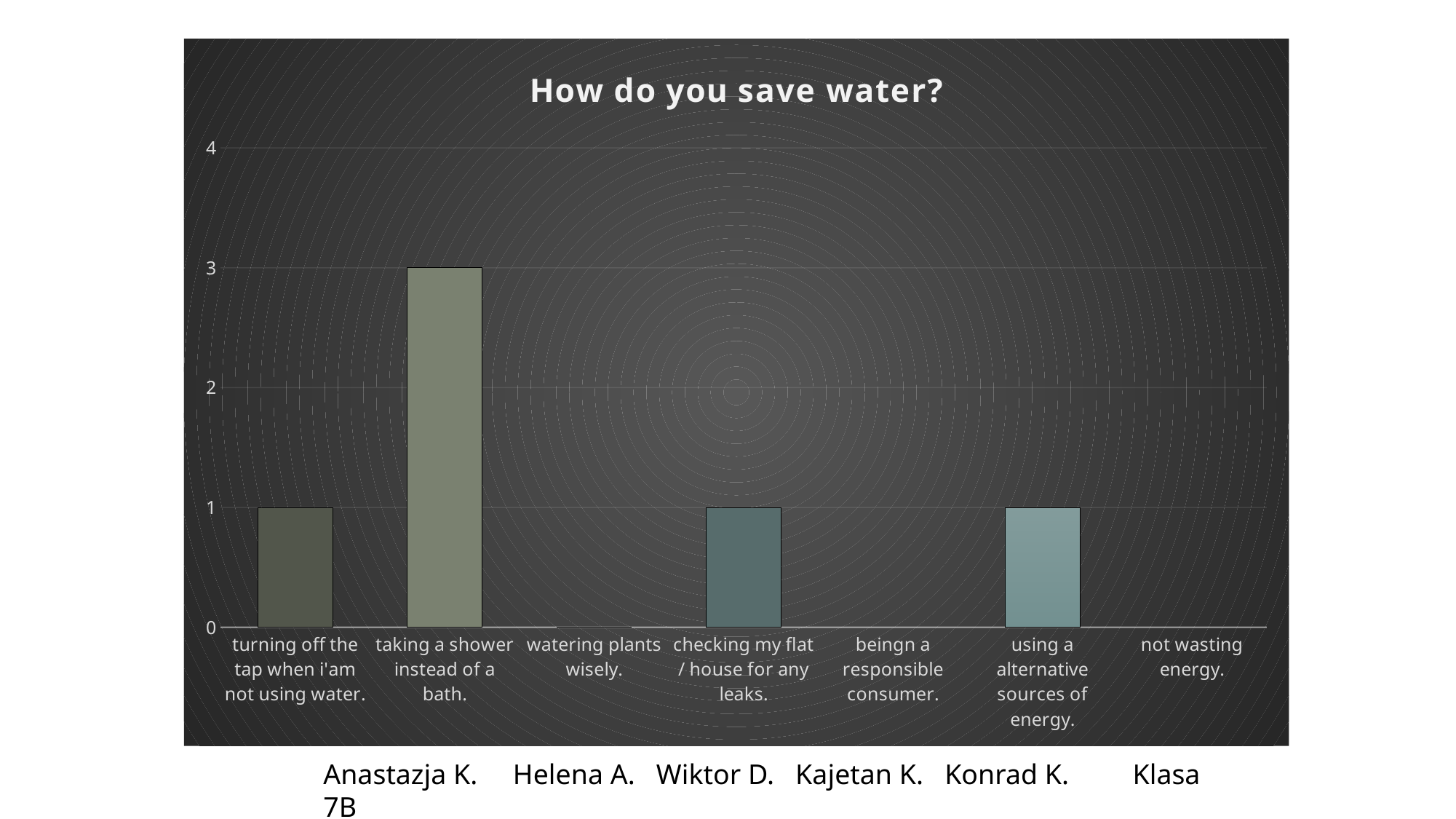
What is the difference between the values for "taking a shower instead of a bath." and "turning off the tap when i'am not using water."? 2 Is the value for "taking a shower instead of a bath." greater or less than 2? greater What is the title of the chart? How do you save water? What is the value for "turning off the tap when i'am not using water."? 1 What is the value for "checking my flat / house for any leaks."? 1 Which is larger, the value for "taking a shower instead of a bath." or the value for "checking my flat / house for any leaks."? taking a shower instead of a bath. How many categories are shown on the x axis of the chart? 7 What is the value for "taking a shower instead of a bath."? 3 What is the value for "using a alternative sources of energy."? 1 What type of chart is shown on the slide? bar chart Which category has the highest value? taking a shower instead of a bath.